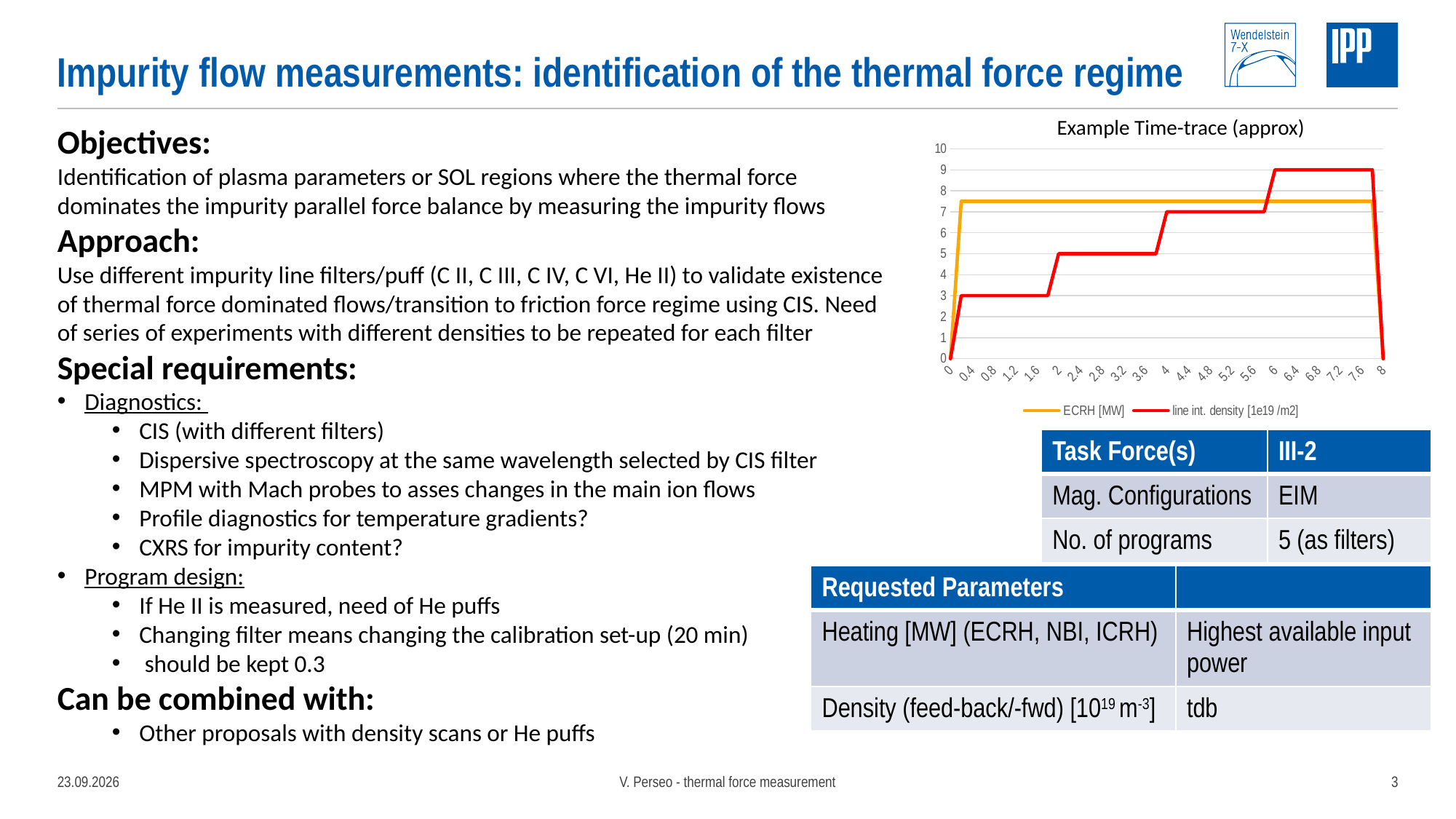
In the "Example Time-trace (approx)" chart, is the line int. density value at x = 1 greater or less than 4? less In the "Example Time-trace (approx)" chart, which series has the higher value at x = 6.4? line int. density [1e19 /m2] In the "Example Time-trace (approx)" chart, is the ECRH [MW] value at x = 4 greater or less than 7? greater In the "Example Time-trace (approx)" chart, does the line int. density series rise or fall between x = 0.4 and x = 7.6? rise In the "Example Time-trace (approx)" chart, is the line int. density value at x = 6.4 greater or less than 8? greater In the "Example Time-trace (approx)" chart, which colour is the ECRH [MW] series drawn in? orange What is the title of the chart on the slide? Example Time-trace (approx) In the "Example Time-trace (approx)" chart, what is the highest value reached by the line int. density series? 9 How many series does the legend of the "Example Time-trace (approx)" chart list? 2 What kind of chart is the "Example Time-trace (approx)" chart? line chart In the "Example Time-trace (approx)" chart, which series has the higher value at x = 1? ECRH [MW]